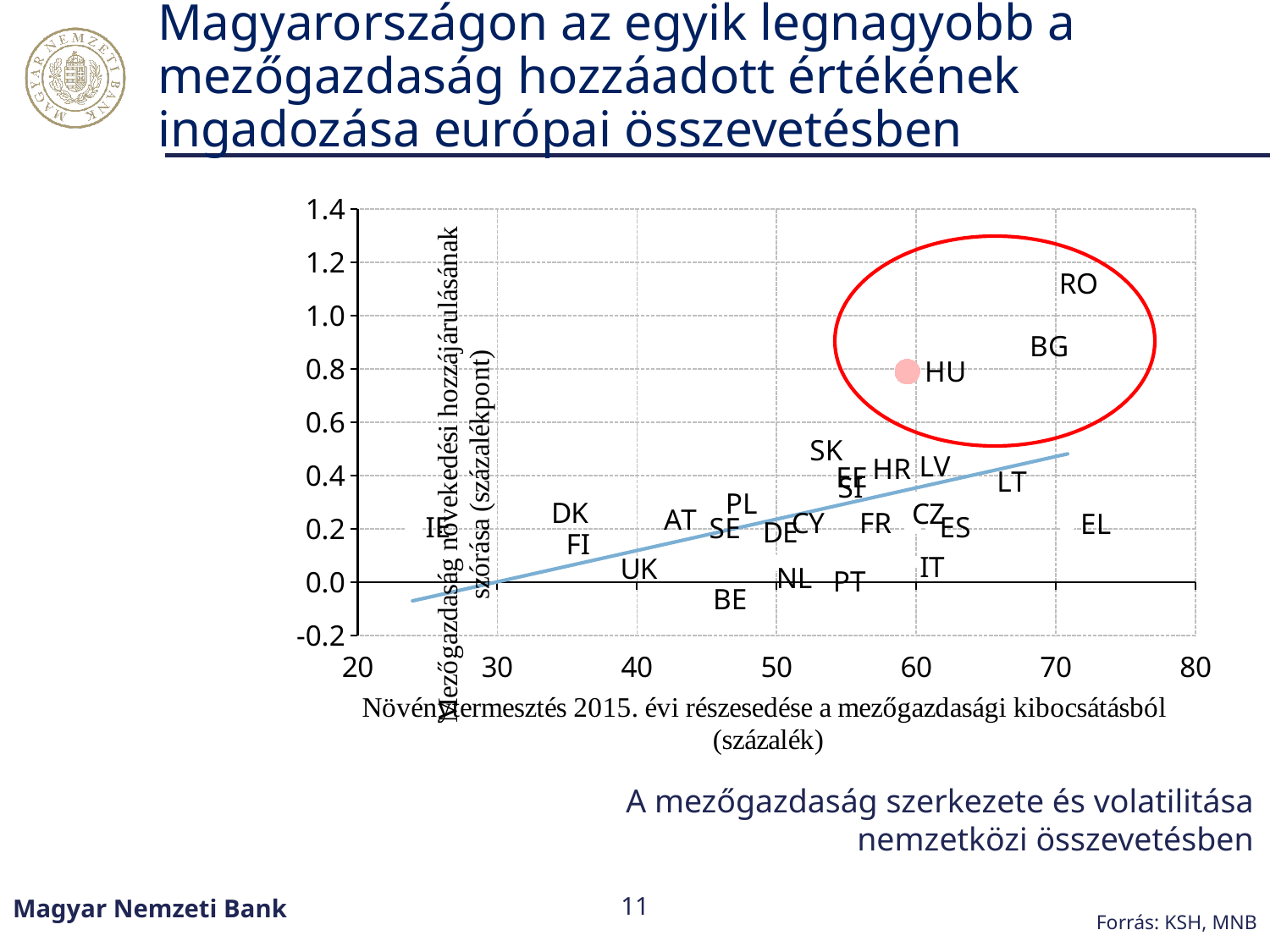
Which country is marked with a filled pink dot on the chart? HU What kind of chart is shown on the slide? scatter chart Which country has the lowest value on the vertical axis? BE Is the vertical-axis value for HU greater or less than 0.6? greater Is the horizontal-axis value for IE greater or less than 30? less Which countries are enclosed by the red circle on the chart? HU, BG, RO Is the vertical-axis value for BE greater or less than 0.0? less Does the fitted trend line rise or fall as the horizontal-axis value increases? rise Which has the higher vertical-axis value, RO or HU? RO Which country has the highest value on the vertical axis? RO